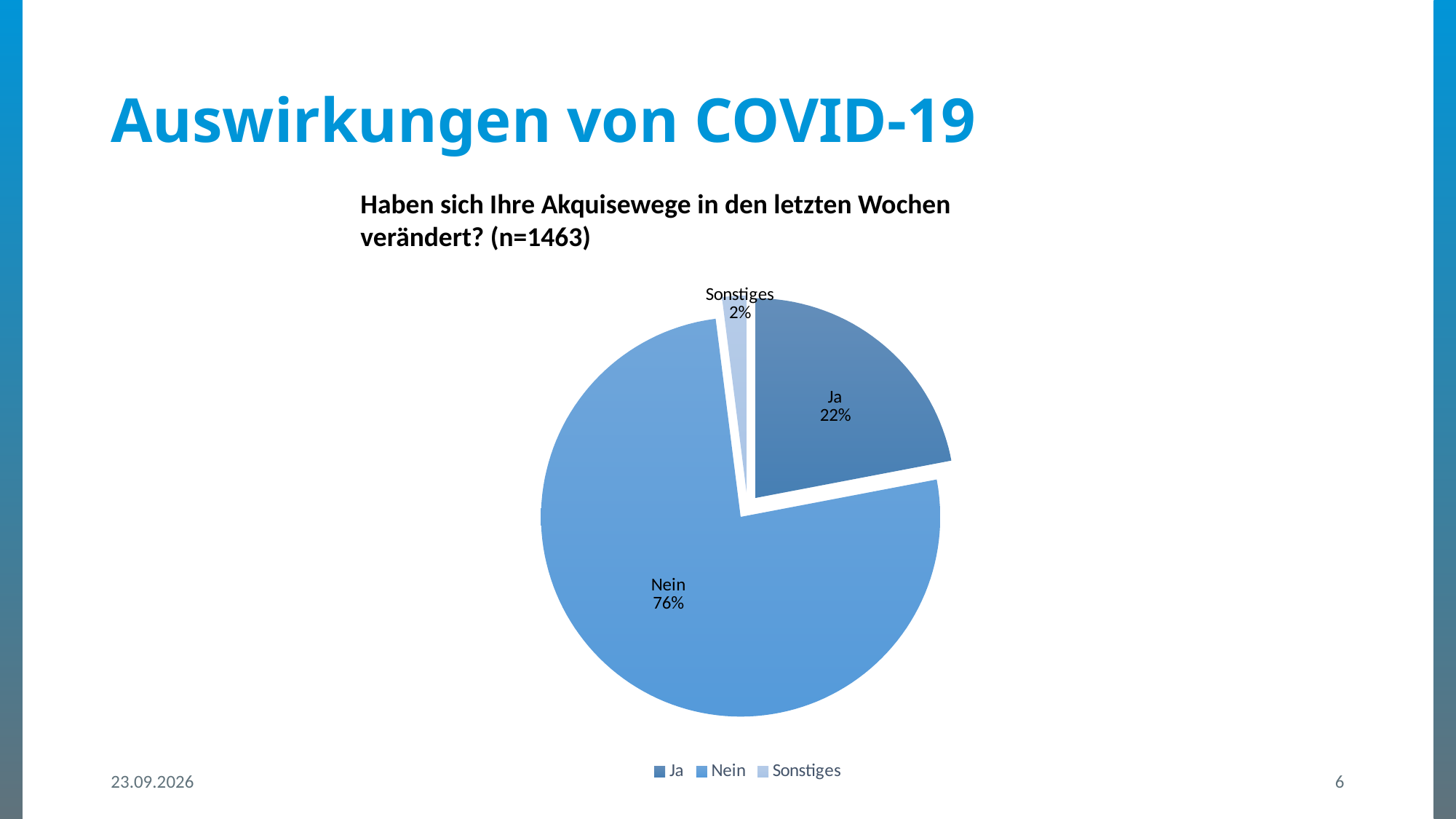
What is the difference in percentage points between the "Ja" and "Sonstiges" slices? 20 What is the sample size (n) stated in the chart title? 1463 What is the difference in percentage points between the "Nein" and "Ja" slices? 54 How many categories are shown in the pie chart? 3 What share of the pie does "Sonstiges" represent? 2% Which slice is larger, "Ja" or "Sonstiges"? Ja What share of the pie does "Nein" represent? 76% What kind of chart is shown on the slide? Pie chart Which category has the smallest slice of the pie? Sonstiges Which category has the largest slice of the pie? Nein What share of the pie does "Ja" represent? 22% Which entries does the legend list, in order? Ja, Nein, Sonstiges